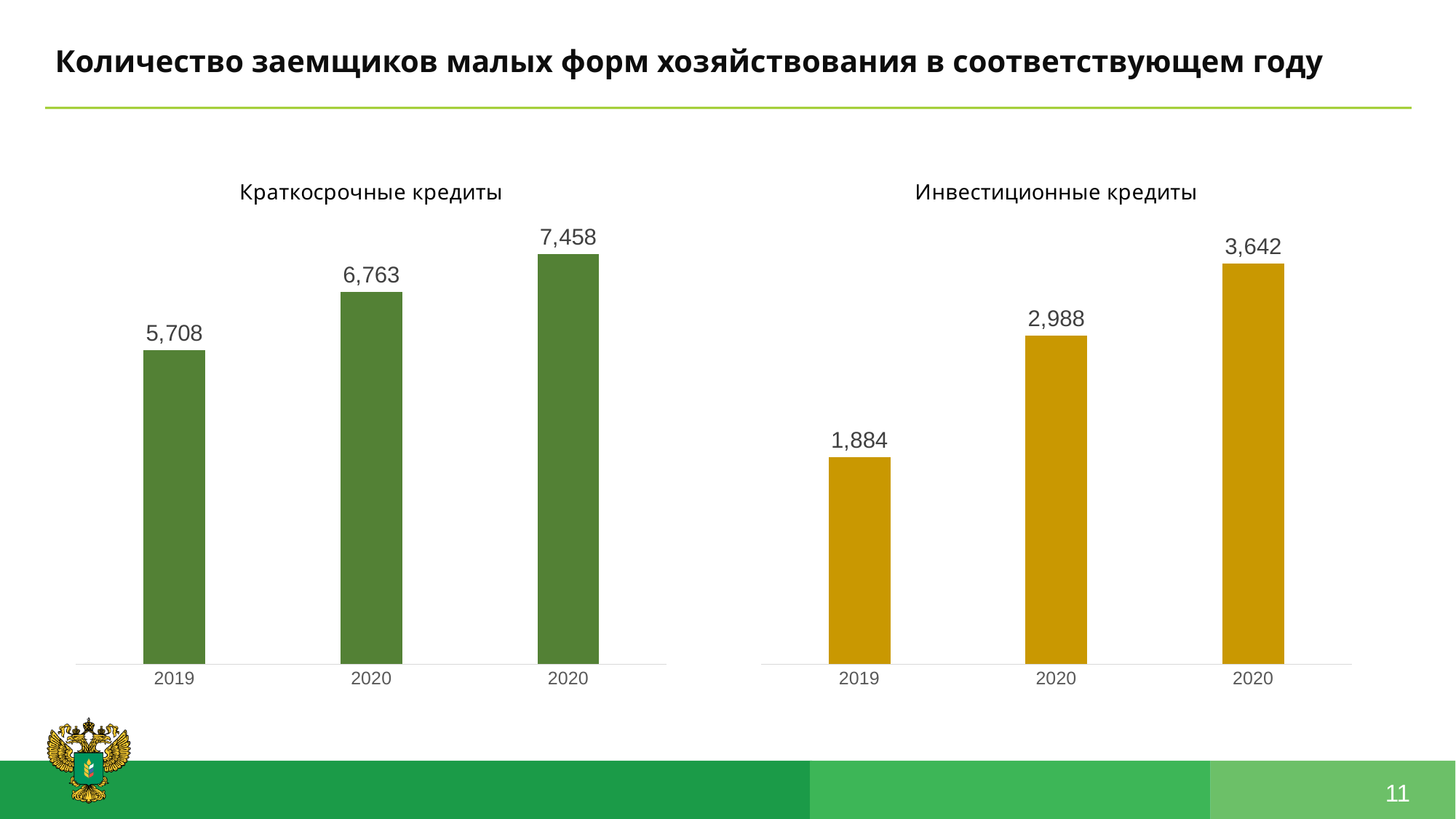
In the 'Краткосрочные кредиты' chart, what is the value for 2019? 5,708 Which is larger: the 2019 value in the 'Краткосрочные кредиты' chart or the rightmost value in the 'Инвестиционные кредиты' chart? 2019 value in 'Краткосрочные кредиты' How many bars does the 'Инвестиционные кредиты' chart have? 3 In the 'Инвестиционные кредиты' chart, what is the value of the middle bar? 2,988 In the 'Краткосрочные кредиты' chart, what is the value of the middle bar? 6,763 Do the values in the 'Краткосрочные кредиты' chart rise or fall from left to right? rise In the 'Инвестиционные кредиты' chart, what is the value for 2019? 1,884 In the 'Краткосрочные кредиты' chart, what is the lowest value shown? 5,708 In the 'Краткосрочные кредиты' chart, what is the difference between the rightmost bar and the 2019 bar? 1,750 In the 'Инвестиционные кредиты' chart, what is the difference between the rightmost bar and the 2019 bar? 1,758 In the 'Инвестиционные кредиты' chart, what is the highest value shown? 3,642 In the 'Краткосрочные кредиты' chart, what is the value of the rightmost bar? 7,458